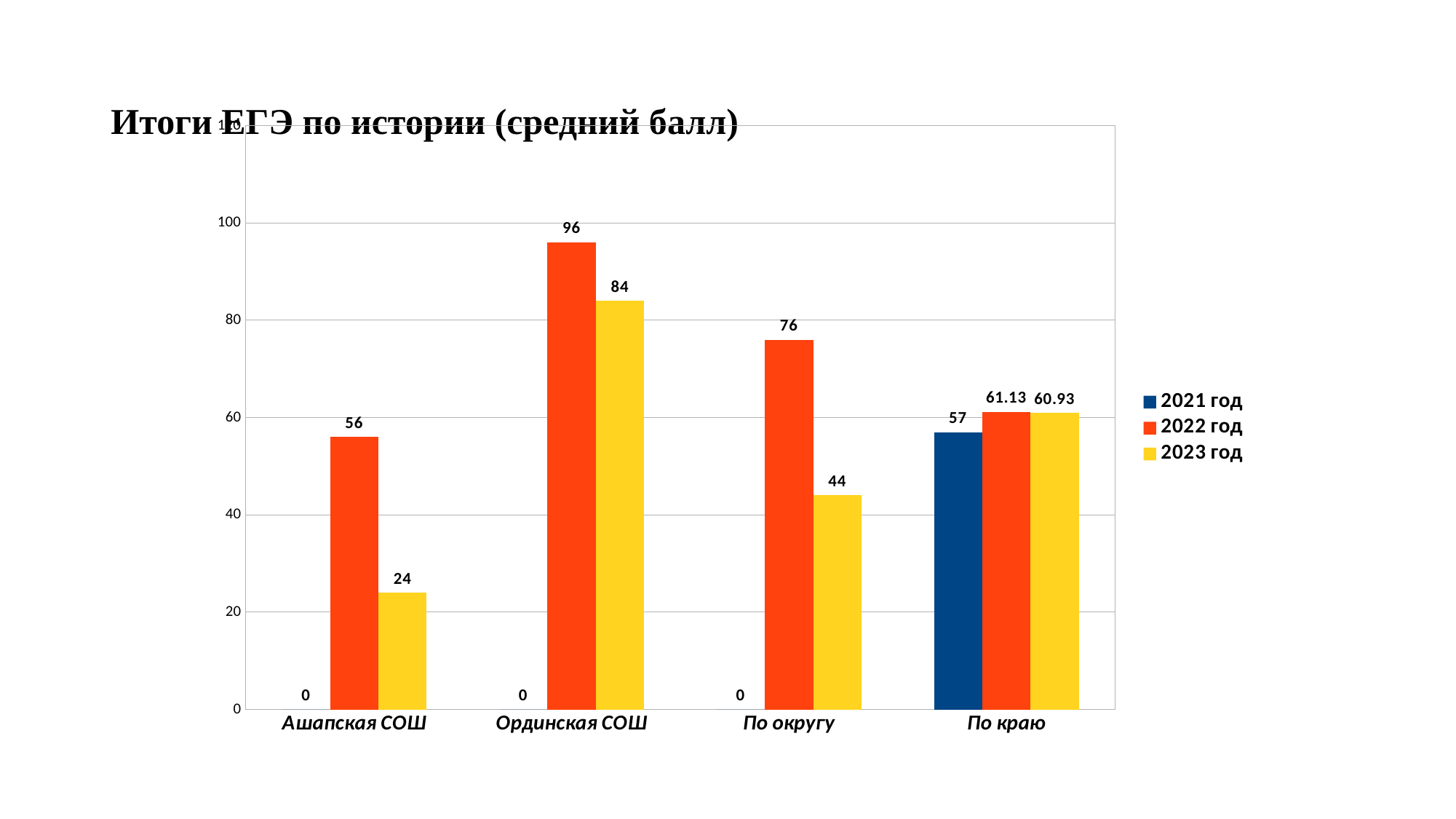
How many series does the legend list? 3 What is the difference between the 2022 год and 2023 год values for Ашапская СОШ? 32 How many categories are shown on the x axis? 4 What is the value for По округу in the 2023 год series? 44 Which is larger for По округу: the 2022 год value or the 2023 год value? 2022 год What is the title of the chart? Итоги ЕГЭ по истории (средний балл) Which category has the lowest value in the 2023 год series? Ашапская СОШ What kind of chart is shown on the slide? Bar chart What is the value for По краю in the 2023 год series? 60.93 Which category has the highest value in the 2022 год series? Ординская СОШ What is the value for По краю in the 2021 год series? 57 What is the value for Ординская СОШ in the 2022 год series? 96